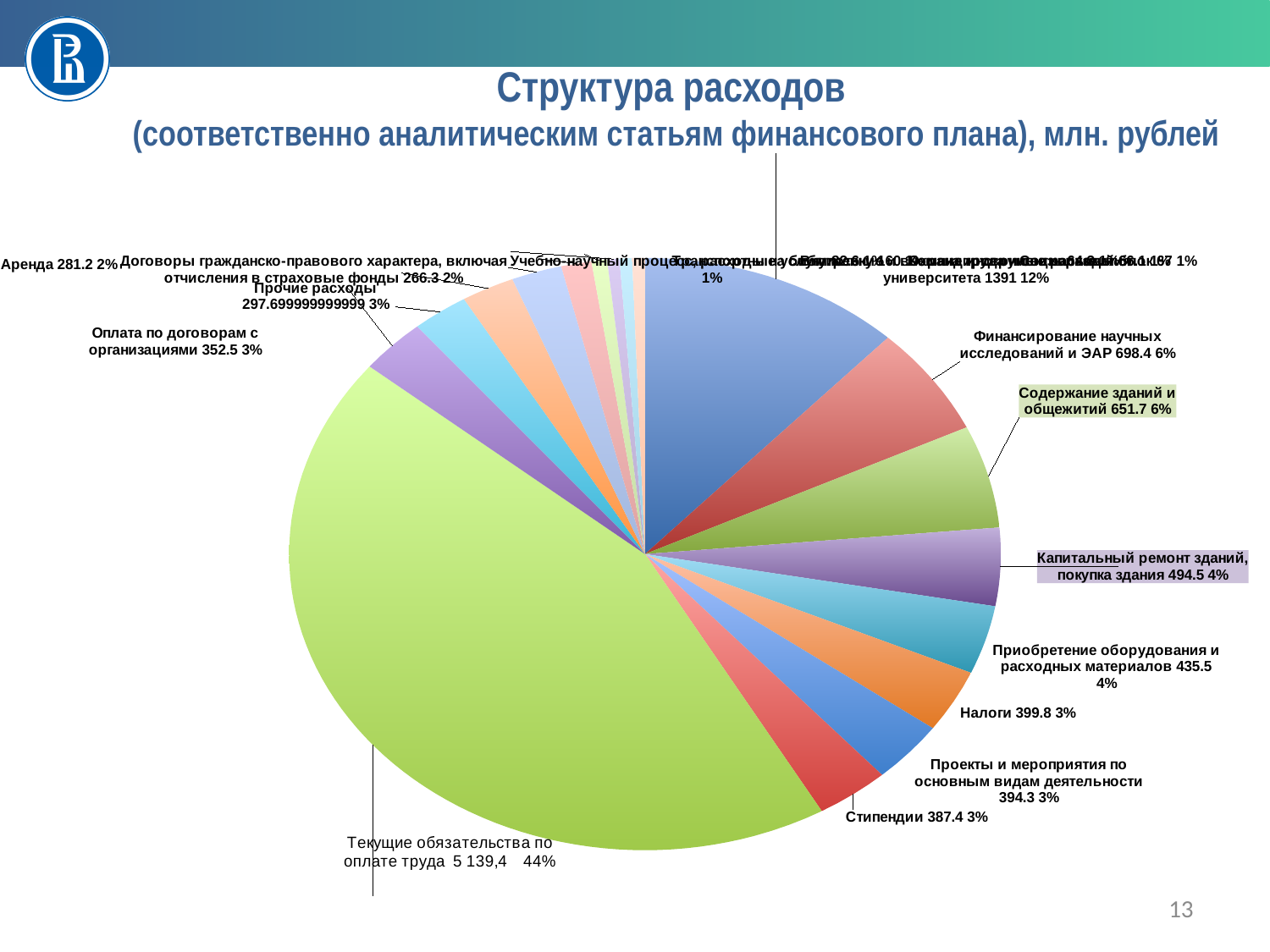
What is the value shown for Оплата по договорам с организациями? 352.5 What share of the pie does Текущие обязательства по оплате труда account for? 44% What is the value shown for Аренда? 281.2 What is the value shown for Налоги? 399.8 Which is larger: Содержание зданий и общежитий or Финансирование научных исследований и ЭАР? Финансирование научных исследований и ЭАР What is the value shown for Финансирование научных исследований и ЭАР? 698.4 What share of the pie does Капитальный ремонт зданий, покупка здания account for? 4% What kind of chart is shown on the slide? pie chart What is the difference between the values for Приобретение оборудования и расходных материалов and Налоги? 35.7 What is the title of the chart? Структура расходов (соответственно аналитическим статьям финансового плана), млн. рублей Which category has the largest share of the pie? Текущие обязательства по оплате труда What share of the pie does Стипендии account for? 3%